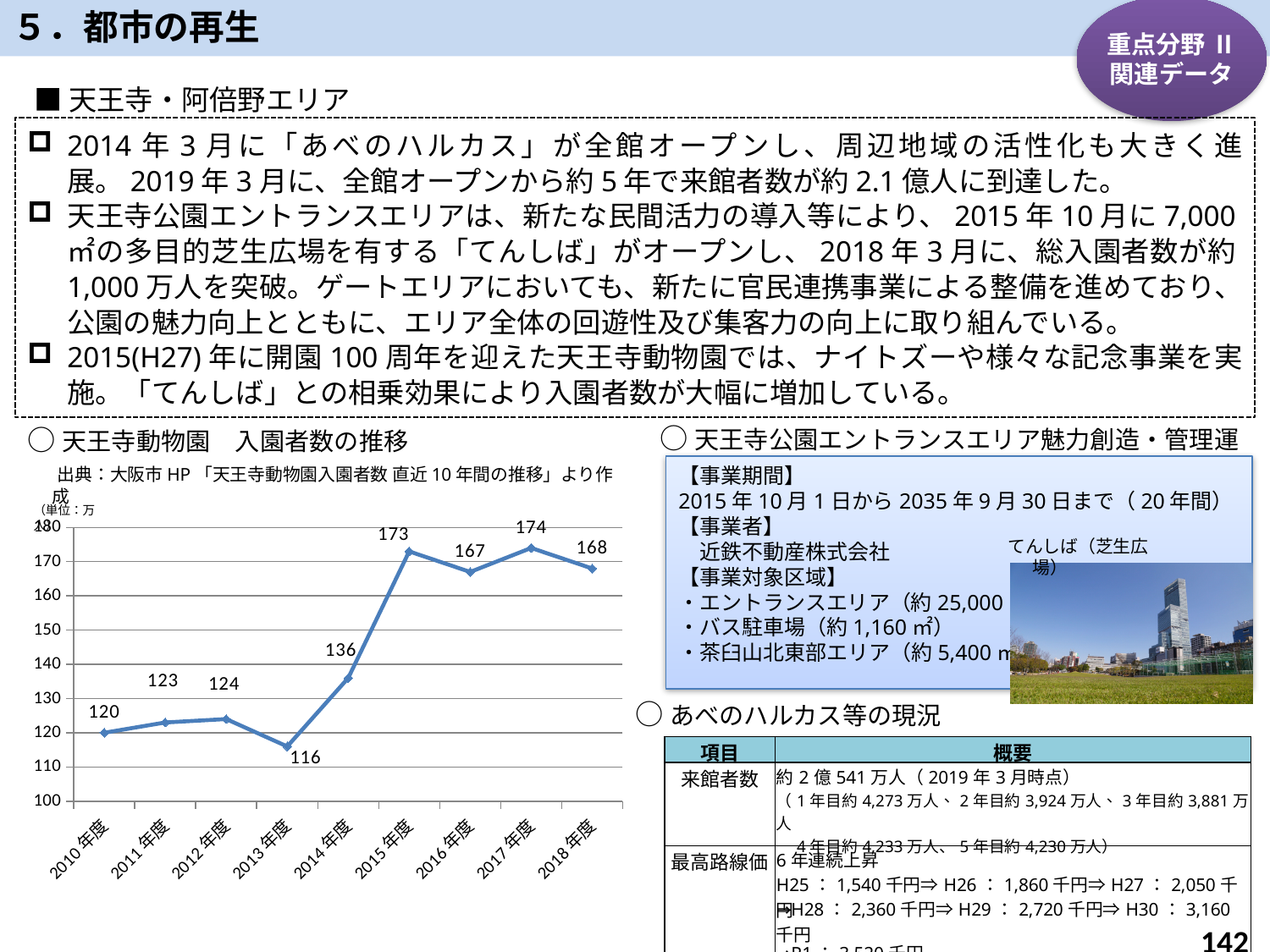
What unit is indicated for the values in the 天王寺動物園 入園者数の推移 chart? 万 In the 天王寺動物園 入園者数の推移 chart, which fiscal year has the highest value? 2017年度 What type of chart is used to show the 天王寺動物園 入園者数の推移? Line chart In the 天王寺動物園 入園者数の推移 chart, what is the value for 2018年度? 168 In the 天王寺動物園 入園者数の推移 chart, what is the value for 2010年度? 120 In the 天王寺動物園 入園者数の推移 chart, which fiscal year has the lowest value? 2013年度 In the 天王寺動物園 入園者数の推移 chart, which is larger, the value for 2016年度 or 2018年度? 2018年度 In the 天王寺動物園 入園者数の推移 chart, what is the difference between the values for 2015年度 and 2014年度? 37 In the 天王寺動物園 入園者数の推移 chart, what is the value for 2015年度? 173 In the 天王寺動物園 入園者数の推移 chart, does the value rise or fall from 2012年度 to 2013年度? Fall How many fiscal years are plotted in the 天王寺動物園 入園者数の推移 chart? 9 In the 天王寺動物園 入園者数の推移 chart, is the value for 2014年度 greater or less than 130? greater